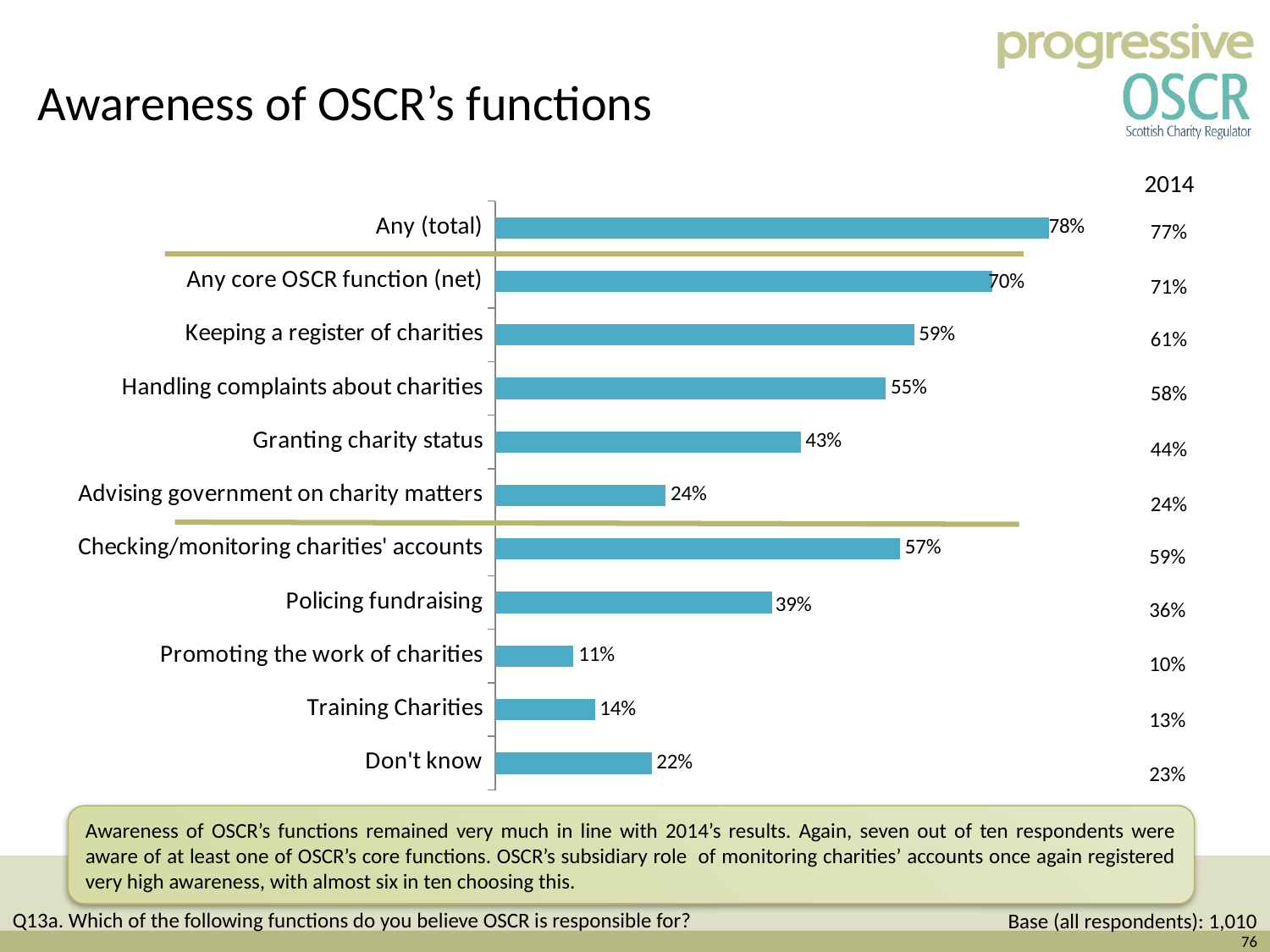
What is the value for 'Don't know'? 22% What is the difference between 'Handling complaints about charities' and 'Granting charity status'? 12% What is the 2014 value listed next to 'Policing fundraising'? 36% Which category has the highest value? Any (total) Which is larger: 'Training Charities' or 'Promoting the work of charities'? Training Charities What kind of chart is shown on the slide? Bar chart Which is larger: 'Checking/monitoring charities' accounts' or 'Keeping a register of charities'? Keeping a register of charities Which category has the lowest value? Promoting the work of charities What is the title of the slide containing the chart? Awareness of OSCR's functions What is the value for 'Policing fundraising'? 39% What is the value for 'Keeping a register of charities'? 59% How many categories are shown in the chart? 11